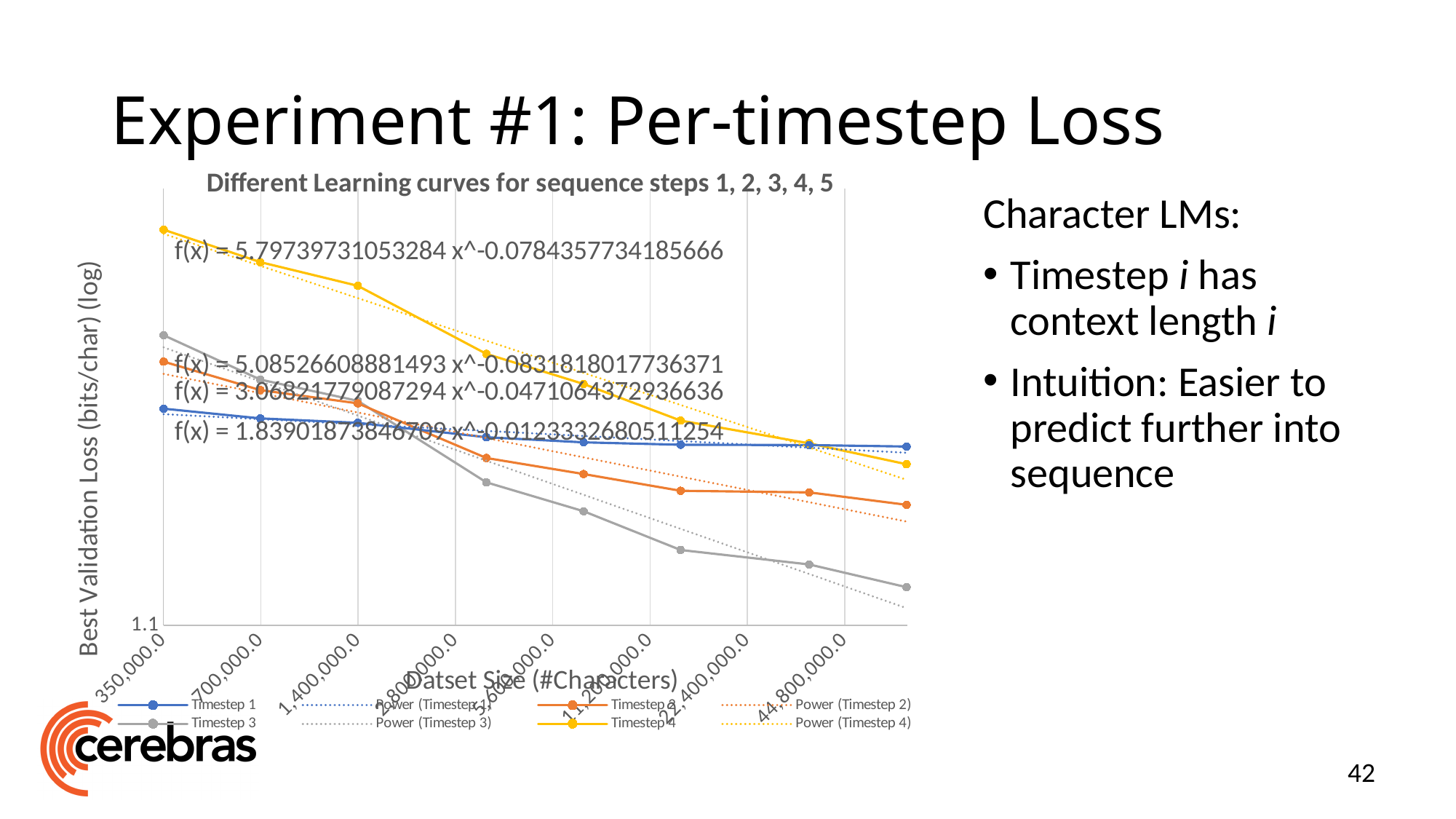
How many entries does the chart legend list? 8 What is the exponent in the power-law fit equation printed at the top of the chart, f(x) = 5.79739731053284 x^? -0.0784357734185666 What is the title of the chart? Different Learning curves for sequence steps 1, 2, 3, 4, 5 Which timestep series has the lowest validation loss at a dataset size of 350,000.0? Timestep 1 Which timestep series has the lowest validation loss at the largest dataset size on the chart? Timestep 3 Which timestep series has the highest validation loss at a dataset size of 350,000.0? Timestep 4 What kind of chart is shown on the slide? Line chart At a dataset size of 350,000.0, which has the larger validation loss: Timestep 2 or Timestep 1? Timestep 2 Is the validation loss for Timestep 3 at a dataset size of 44,800,000.0 greater or less than 1.1? greater At a dataset size of 44,800,000.0, which has the larger validation loss: Timestep 1 or Timestep 3? Timestep 1 Do the validation loss values for Timestep 3 rise or fall as the dataset size increases? Fall What is the label of the vertical axis? Best Validation Loss (bits/char) (log)